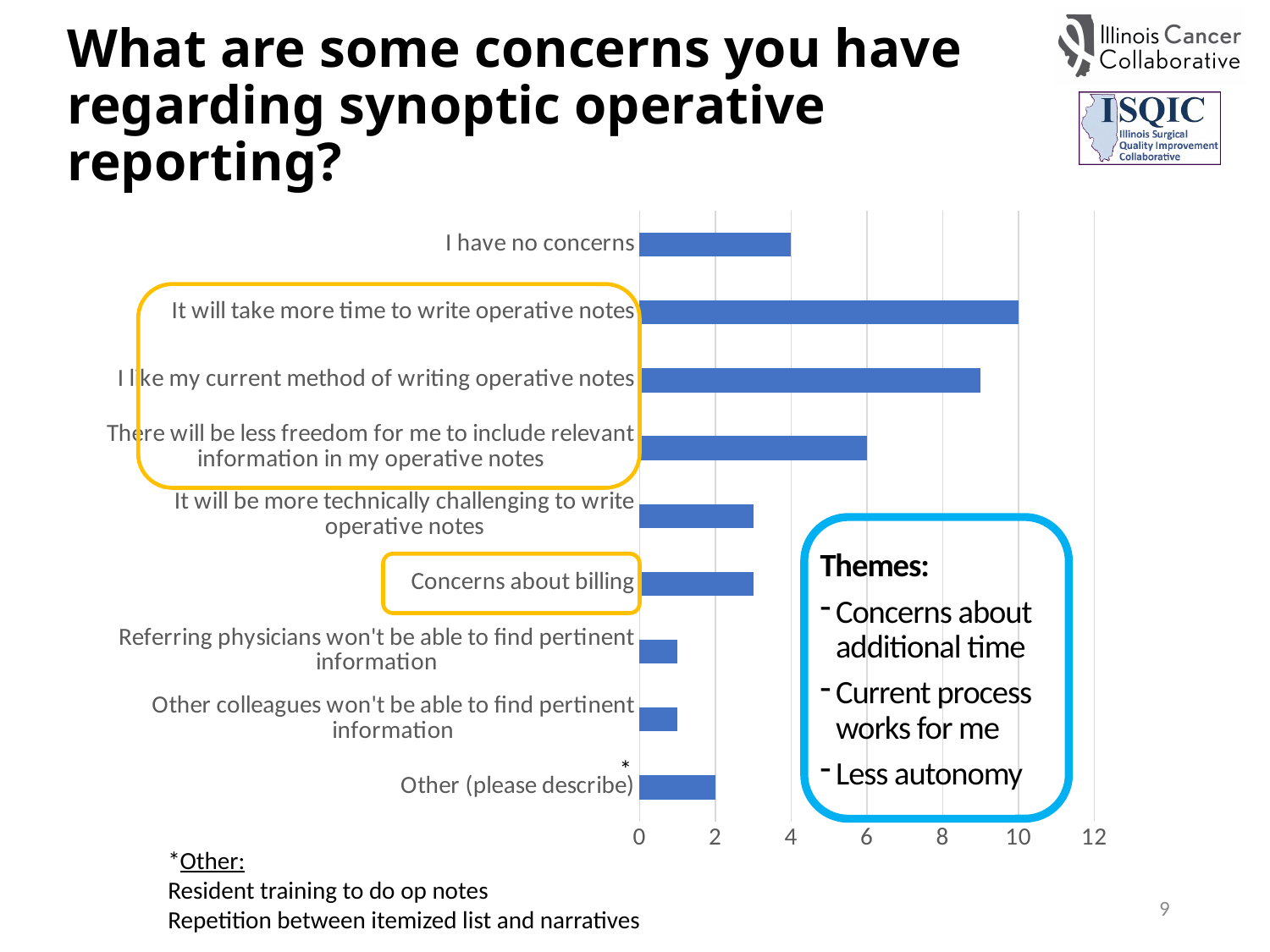
What is the value for "There will be less freedom for me to include relevant information in my operative notes"? 6 What is the difference between the values for "It will take more time to write operative notes" and "I have no concerns"? 6 Is the value for "I like my current method of writing operative notes" greater or less than 8? greater Which concern has the highest value? It will take more time to write operative notes Is the value for "Referring physicians won't be able to find pertinent information" greater or less than 2? less Is the value for "Concerns about billing" greater or less than 4? less What is the value for "It will take more time to write operative notes"? 10 Which is larger: the value for "I have no concerns" or the value for "There will be less freedom for me to include relevant information in my operative notes"? There will be less freedom for me to include relevant information in my operative notes What is the value for "I have no concerns"? 4 How many categories (concerns) are plotted in the chart? 9 What kind of chart is shown on the slide? bar chart What is the value for "Other (please describe)"? 2